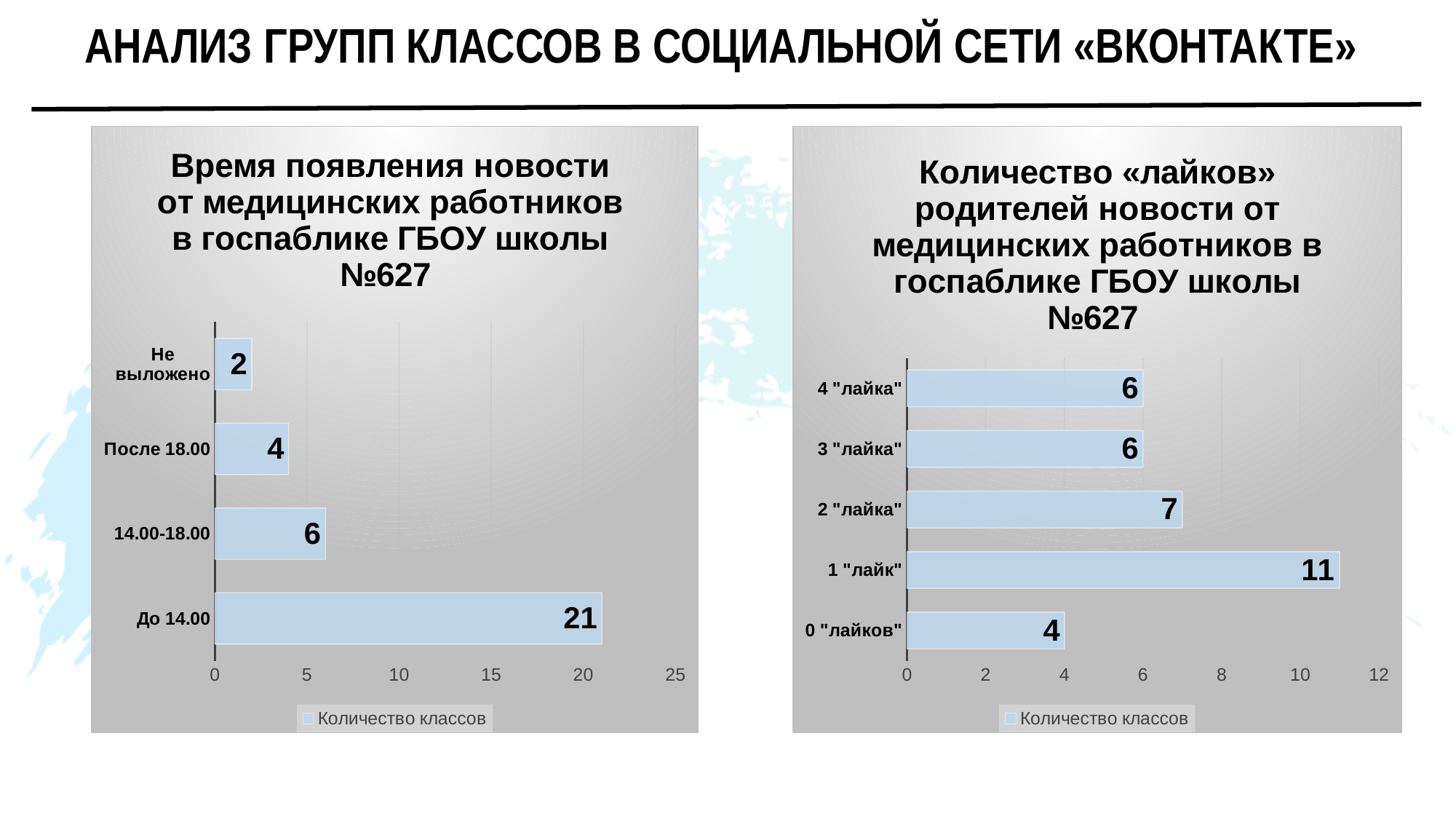
What kind of chart is the right chart (Количество «лайков»)? Bar chart In the right chart (Количество «лайков»), what is the value for '2 "лайка"'? 7 In the left chart (Время появления новости), which category has the lowest value? Не выложено In the left chart (Время появления новости), which category has the highest value? До 14.00 In the right chart (Количество «лайков»), which category has the highest value? 1 "лайк" What series name does the legend of the left chart (Время появления новости) show? Количество классов In the right chart (Количество «лайков»), which is larger: the value for '0 "лайков"' or the value for '2 "лайка"'? 2 "лайка" In the right chart (Количество «лайков»), what is the value for '1 "лайк"'? 11 In the left chart (Время появления новости), what is the difference between the values for 'До 14.00' and '14.00-18.00'? 15 In the left chart (Время появления новости), what is the value for 'После 18.00'? 4 In the left chart (Время появления новости), what is the value for 'До 14.00'? 21 In the left chart (Время появления новости), how many categories are shown? 4